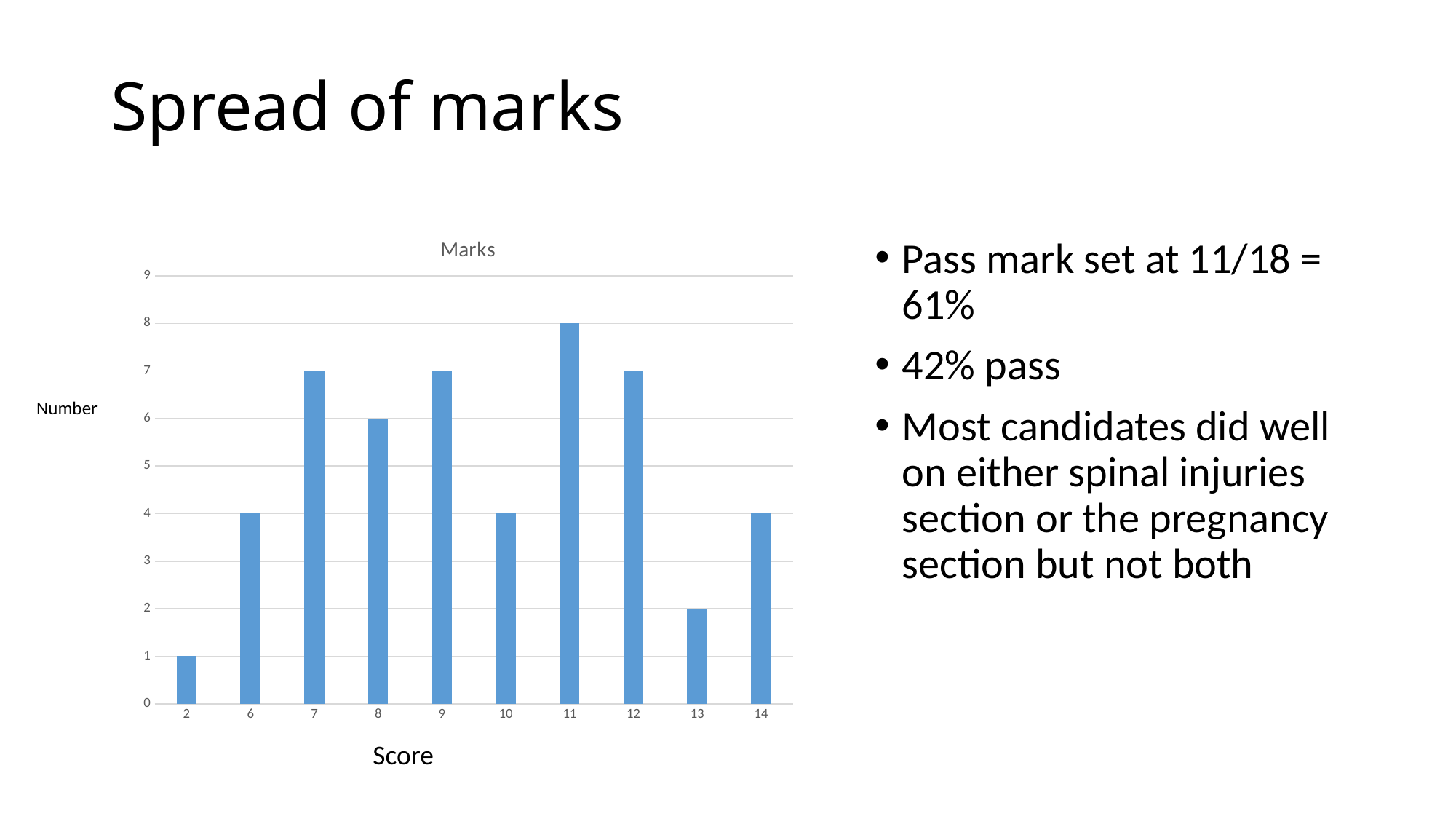
Which has more candidates: a score of 8 or a score of 10? 8 What type of chart is shown on the slide? Bar chart Is the value for a score of 7 greater or less than 5? greater What label is shown on the x axis of the chart? Score How many score categories are shown on the x axis of the chart? 10 What is the number of candidates with a score of 11? 8 What is the number of candidates with a score of 8? 6 What is the difference between the number of candidates scoring 11 and the number scoring 13? 6 Which score has the lowest number of candidates? 2 What is the number of candidates with a score of 13? 2 Which score has the highest number of candidates? 11 What is the title of the chart? Marks